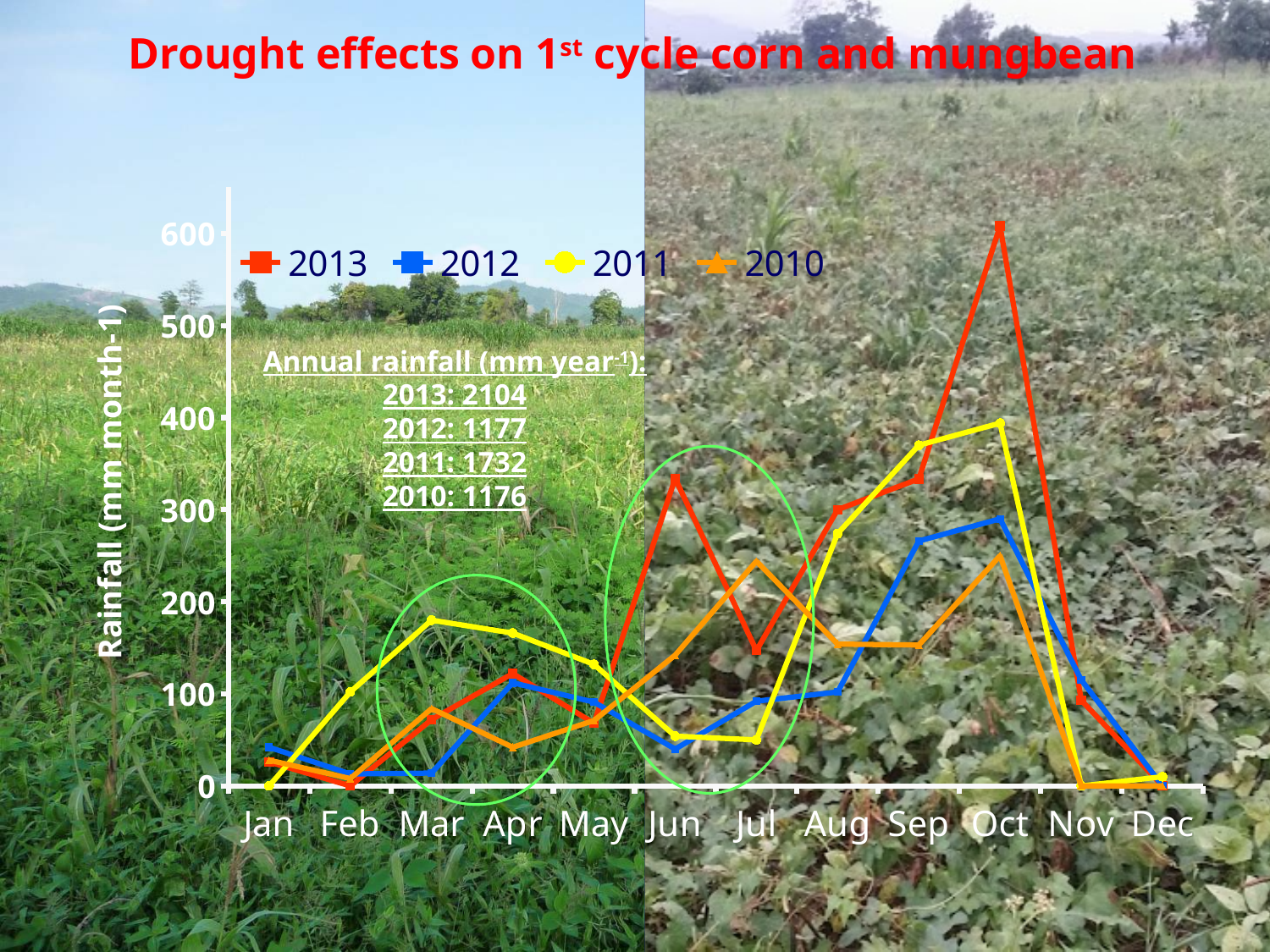
According to the annual rainfall text on the chart, what is the difference between the annual rainfall for 2013 and 2012? 927 What kind of chart is shown on the slide? line chart How many months are plotted along the x axis? 12 In which month does the 2013 series reach its highest value? Oct Is the value for 2012 in Jun greater or less than 100? less Is the value for 2013 in Oct greater or less than 500? greater Which year has the lowest annual rainfall according to the text on the chart? 2010 How many series does the legend list? 4 In Oct, which series has the larger value, 2013 or 2012? 2013 Is the value for 2011 in Mar greater or less than 100? greater What is the label of the y axis? Rainfall (mm month-1) According to the annual rainfall text on the chart, what is the annual rainfall for 2013? 2104